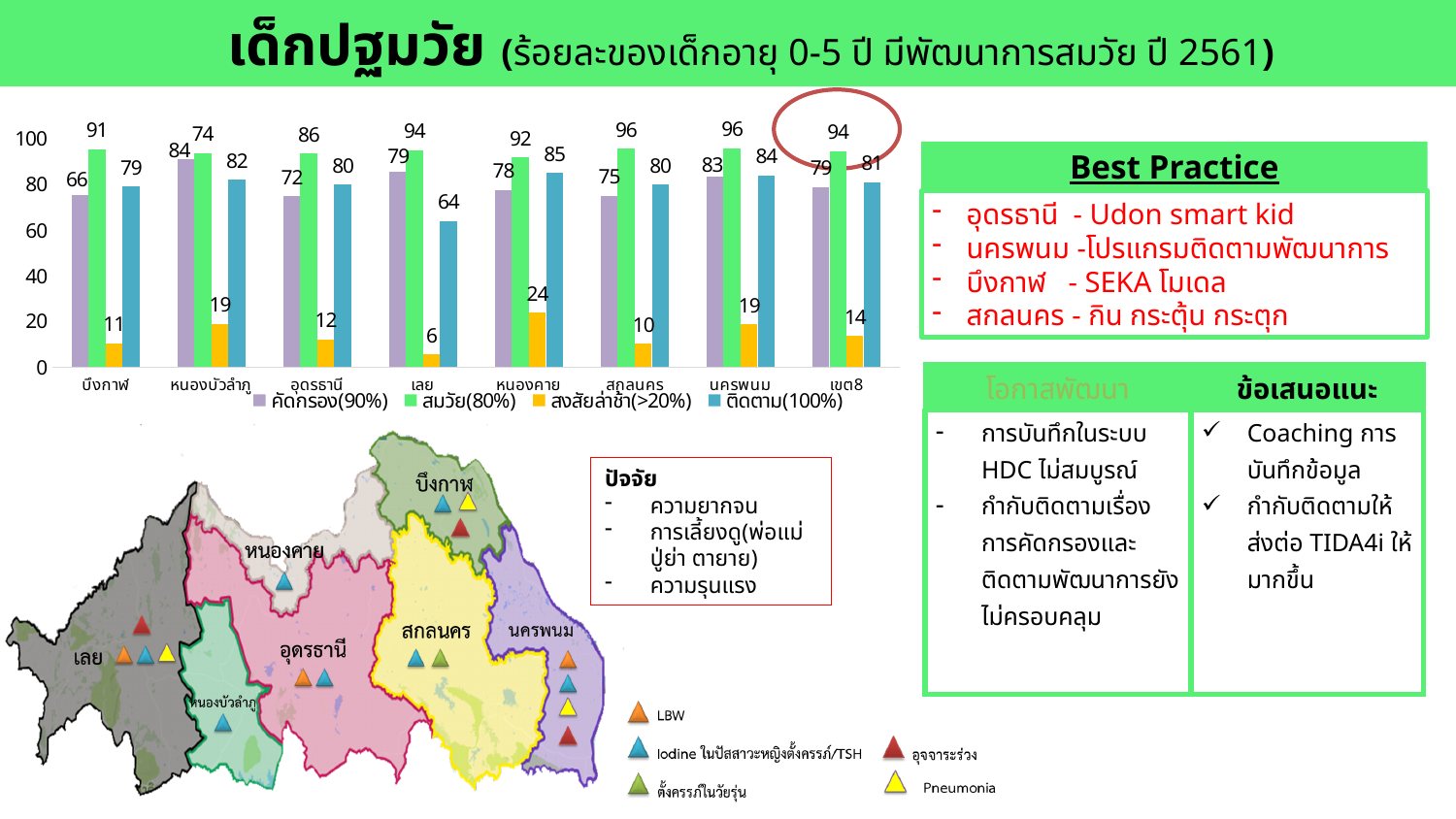
Which has the larger ติดตาม(100%) value, หนองคาย or อุดรธานี? หนองคาย Which category has the highest value for สงสัยล่าช้า(>20%)? หนองคาย How many series does the legend of the bar chart list? 4 What is the value of สงสัยล่าช้า(>20%) for หนองคาย? 24 What is the value of สมวัย(80%) for บึงกาฬ? 91 What is the difference between สมวัย(80%) and คัดกรอง(90%) for บึงกาฬ? 25 What is the value of คัดกรอง(90%) for เขต8? 79 What kind of chart is shown on the left of the slide? bar chart How many provinces/categories are shown on the x axis of the bar chart? 8 Which category has the lowest value for สงสัยล่าช้า(>20%)? เลย Which category has the lowest value for ติดตาม(100%)? เลย What is the value of ติดตาม(100%) for เลย? 64